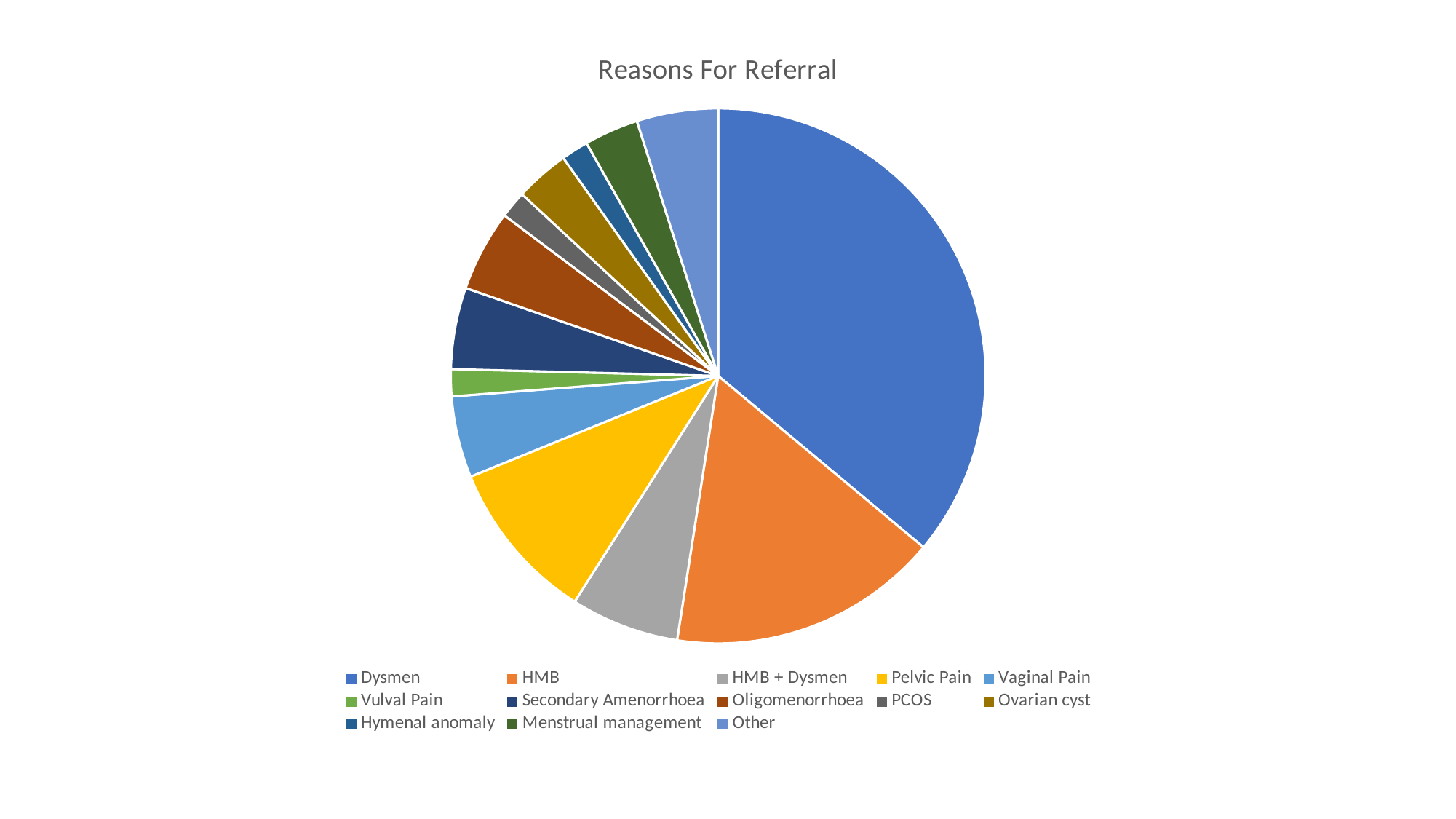
Which slice is larger, HMB + Dysmen or PCOS? HMB + Dysmen What is the title of the chart? Reasons For Referral Which slice is larger, Pelvic Pain or Vaginal Pain? Pelvic Pain Which slice is larger, HMB or Pelvic Pain? HMB What kind of chart is shown on the slide? Pie chart Which reason for referral has the largest slice of the pie? Dysmen How many categories (slices) does the pie chart have? 13 What colour is the Pelvic Pain slice in the chart? Yellow